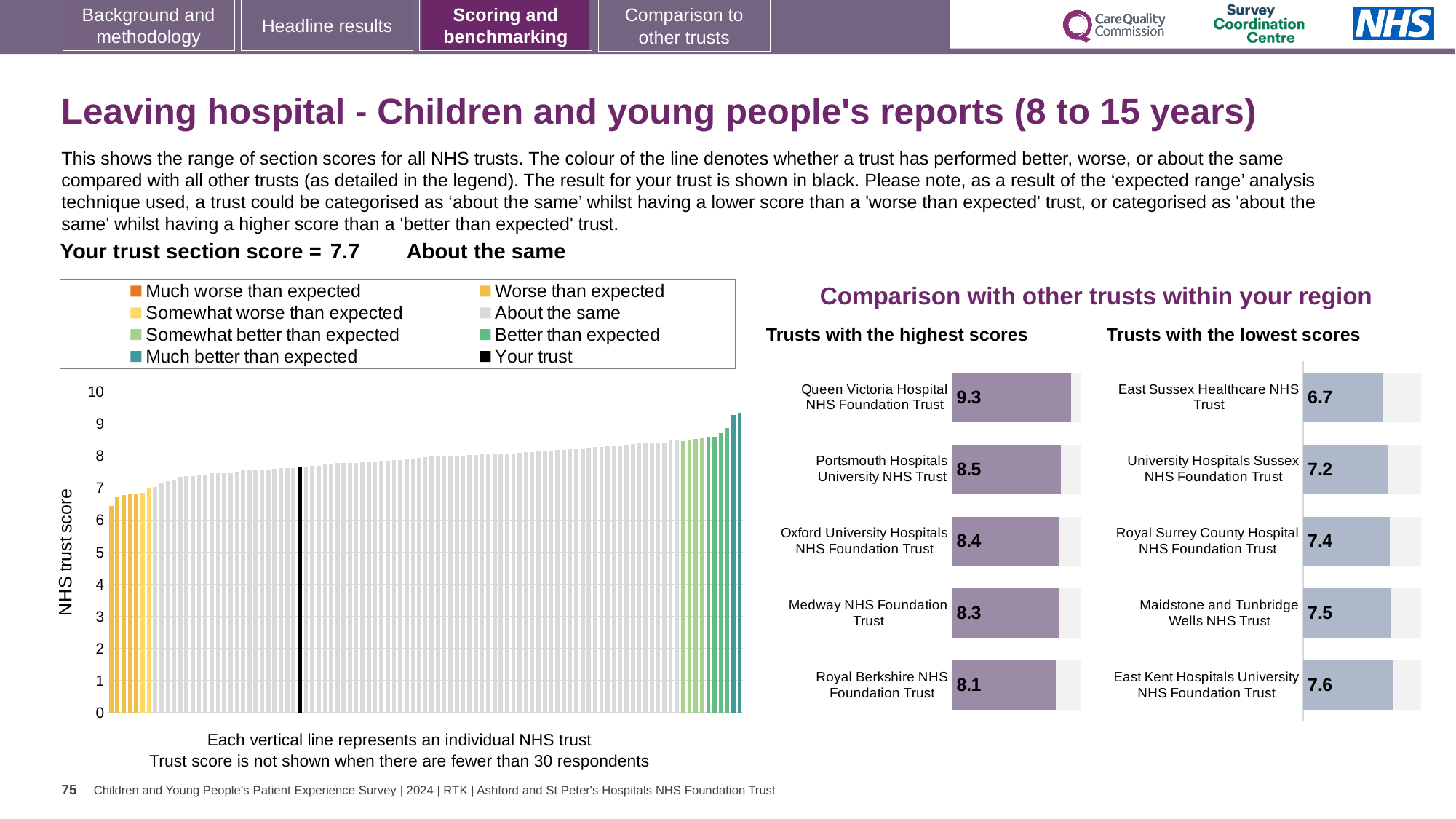
In the 'Trusts with the highest scores' chart, what is the difference between the scores of Queen Victoria Hospital NHS Foundation Trust and Royal Berkshire NHS Foundation Trust? 1.2 How many trusts are shown in the 'Trusts with the highest scores' chart? 5 In the 'Trusts with the lowest scores' chart, which trust has the lowest score? East Sussex Healthcare NHS Trust In the 'Trusts with the lowest scores' chart, which has the higher score: Royal Surrey County Hospital NHS Foundation Trust or University Hospitals Sussex NHS Foundation Trust? Royal Surrey County Hospital NHS Foundation Trust In the main chart on the left, do the trust scores rise or fall from left to right along the x axis? rise In the 'Trusts with the highest scores' chart, which trust has the highest score? Queen Victoria Hospital NHS Foundation Trust In the 'Trusts with the highest scores' chart, what is the score for Medway NHS Foundation Trust? 8.3 In the 'Trusts with the lowest scores' chart, what is the difference between the scores of East Kent Hospitals University NHS Foundation Trust and East Sussex Healthcare NHS Trust? 0.9 In the main chart on the left showing the range of section scores, what is the section score for your trust (the black bar)? 7.7 In the 'Trusts with the lowest scores' chart, what is the score for East Sussex Healthcare NHS Trust? 6.7 In the 'Trusts with the highest scores' chart, what is the score for Queen Victoria Hospital NHS Foundation Trust? 9.3 How many entries does the legend of the main chart on the left list? 8